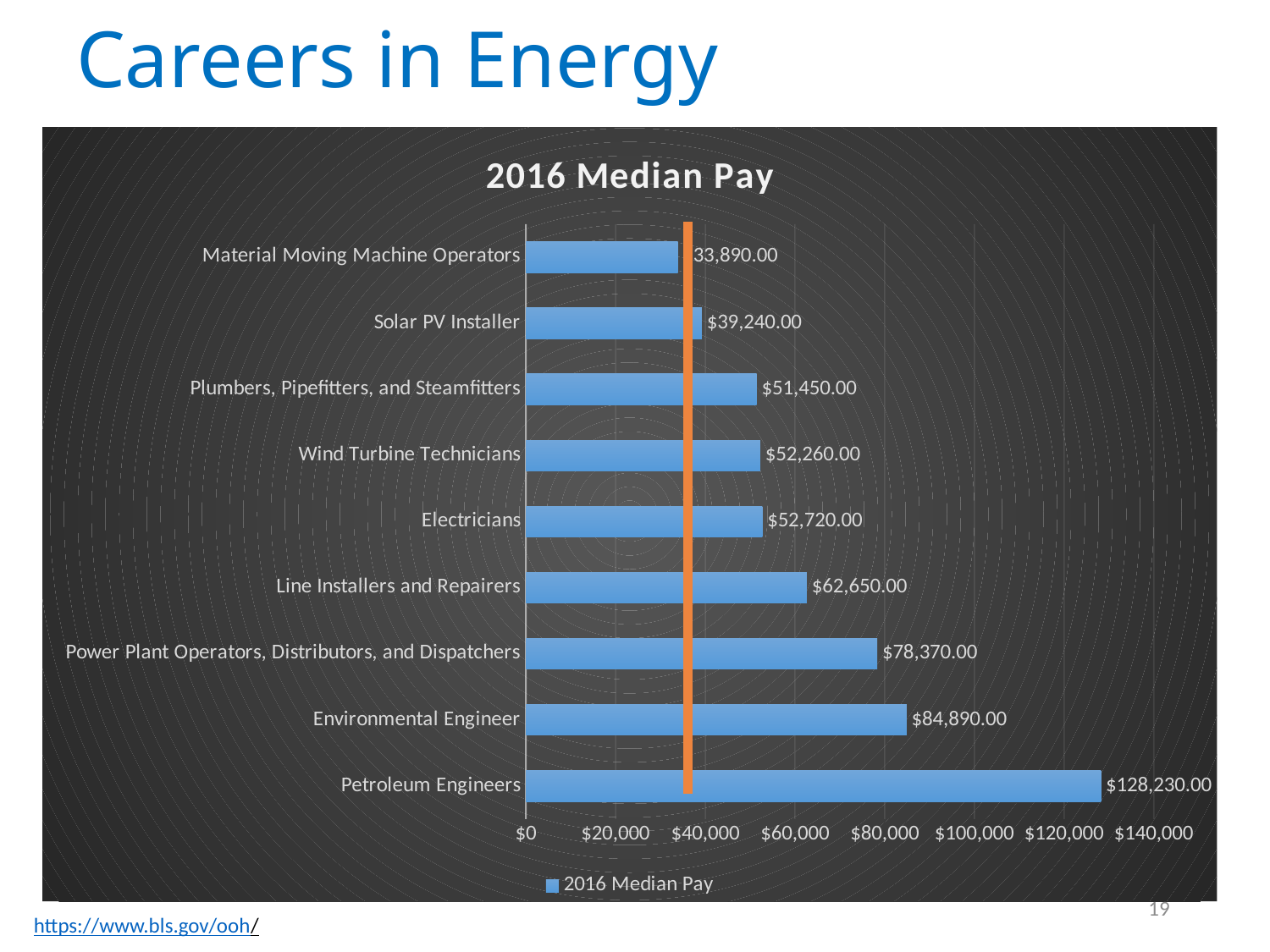
What is the 2016 median pay for Wind Turbine Technicians? $52,260.00 How many careers are shown in the chart? 9 What type of chart is used to show the 2016 median pay? bar chart How much higher is the 2016 median pay for Petroleum Engineers than for Environmental Engineer? $43,340.00 Which career has the lowest 2016 median pay? Material Moving Machine Operators Which has a higher 2016 median pay: Line Installers and Repairers or Plumbers, Pipefitters, and Steamfitters? Line Installers and Repairers What is the difference in 2016 median pay between Line Installers and Repairers and Electricians? $9,930.00 Which career has the highest 2016 median pay? Petroleum Engineers What is the 2016 median pay for Solar PV Installer? $39,240.00 What is the 2016 median pay for Plumbers, Pipefitters, and Steamfitters? $51,450.00 What is the 2016 median pay for Petroleum Engineers? $128,230.00 Is the 2016 median pay for Power Plant Operators, Distributors, and Dispatchers greater or less than $60,000? greater